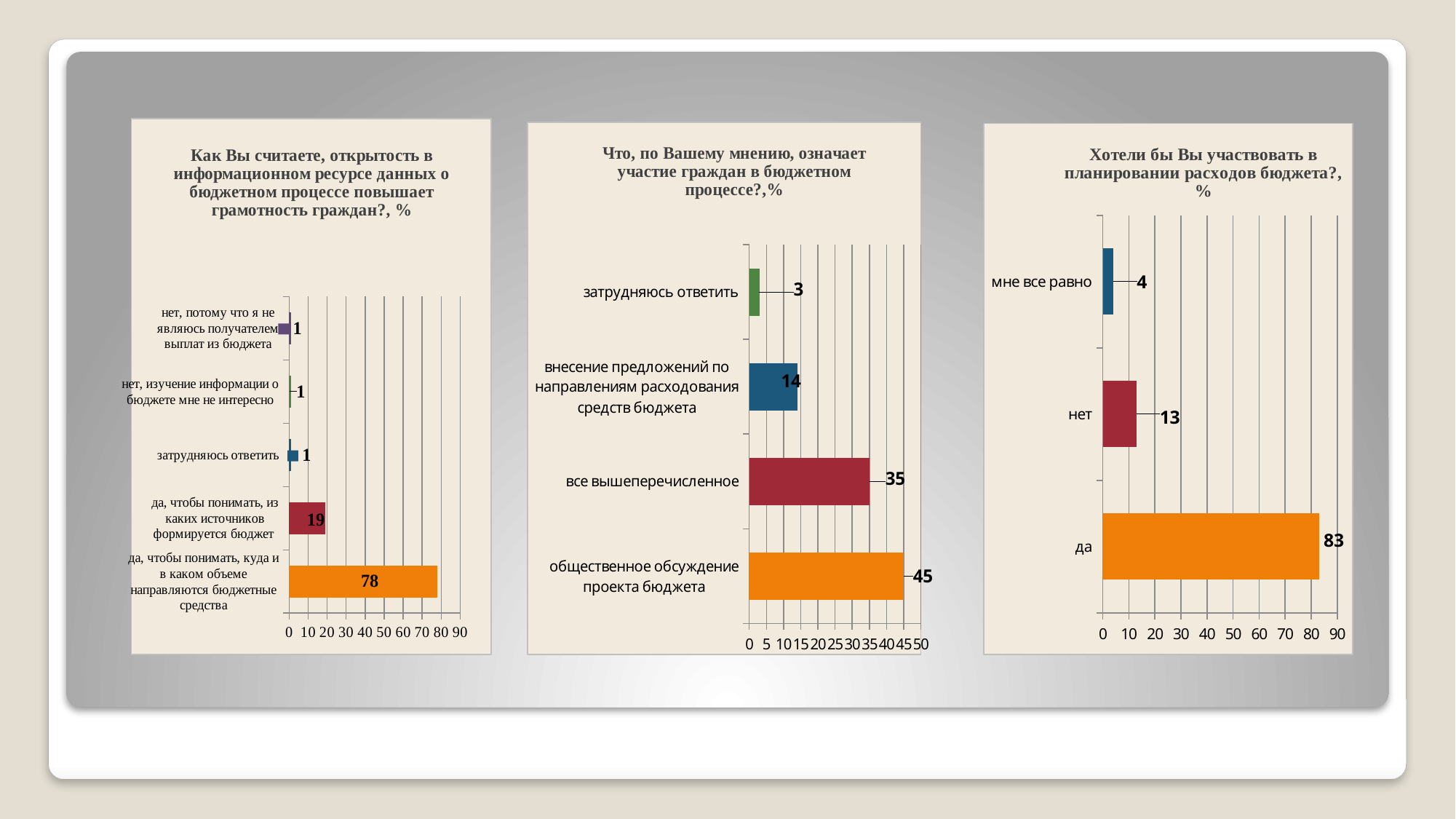
In the right chart ("Хотели бы Вы участвовать в планировании расходов бюджета?"), what is the value for "нет"? 13 In the left chart ("Как Вы считаете, открытость в информационном ресурсе данных о бюджетном процессе повышает грамотность граждан?"), which category has the highest value? да, чтобы понимать, куда и в каком объеме направляются бюджетные средства In the right chart ("Хотели бы Вы участвовать в планировании расходов бюджета?"), which category has the lowest value? мне все равно In the left chart ("Как Вы считаете, открытость в информационном ресурсе данных о бюджетном процессе повышает грамотность граждан?"), what is the value for "да, чтобы понимать, из каких источников формируется бюджет"? 19 In the right chart ("Хотели бы Вы участвовать в планировании расходов бюджета?"), what is the value for "да"? 83 In the right chart ("Хотели бы Вы участвовать в планировании расходов бюджета?"), what is the difference between the values for "да" and "нет"? 70 In the middle chart ("Что, по Вашему мнению, означает участие граждан в бюджетном процессе?"), which category has the highest value? общественное обсуждение проекта бюджета In the middle chart ("Что, по Вашему мнению, означает участие граждан в бюджетном процессе?"), what is the difference between "общественное обсуждение проекта бюджета" and "внесение предложений по направлениям расходования средств бюджета"? 31 In the middle chart ("Что, по Вашему мнению, означает участие граждан в бюджетном процессе?"), what is the value for "все вышеперечисленное"? 35 What type of chart is the right chart ("Хотели бы Вы участвовать в планировании расходов бюджета?")? bar chart In the left chart ("Как Вы считаете, открытость в информационном ресурсе данных о бюджетном процессе повышает грамотность граждан?"), how many categories are shown? 5 In the middle chart ("Что, по Вашему мнению, означает участие граждан в бюджетном процессе?"), how many categories are shown? 4